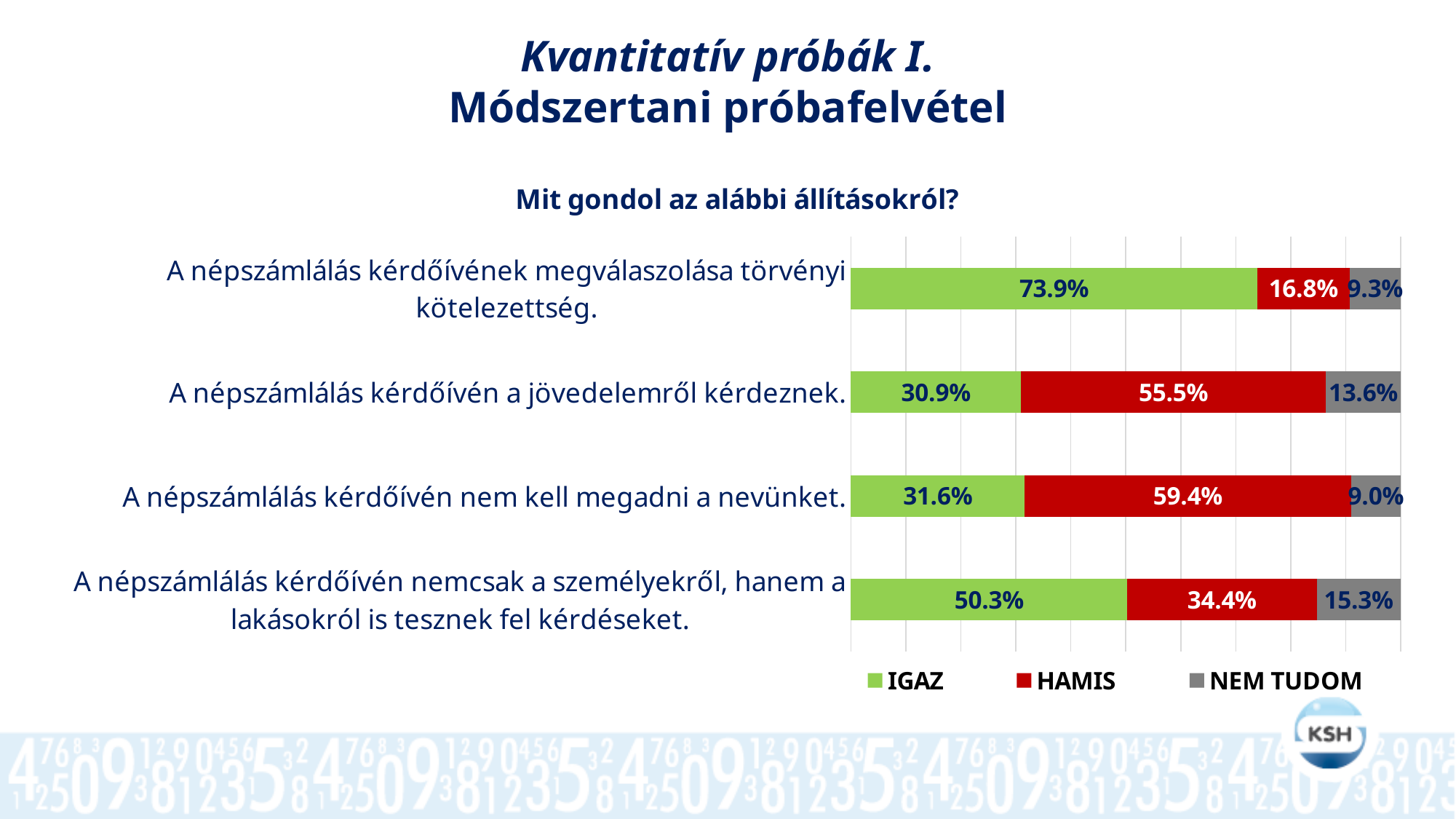
How many statements (categories) are shown in the chart? 4 How many series does the legend list? 3 What is the total of the stacked bar for "A népszámlálás kérdőívén nem kell megadni a nevünket."? 100.0% What is the IGAZ value for the statement "A népszámlálás kérdőívének megválaszolása törvényi kötelezettség."? 73.9% Which statement has the highest NEM TUDOM value? A népszámlálás kérdőívén nemcsak a személyekről, hanem a lakásokról is tesznek fel kérdéseket. What is the difference in percentage points between the HAMIS value for "A népszámlálás kérdőívén nem kell megadni a nevünket." and the HAMIS value for "A népszámlálás kérdőívén nemcsak a személyekről, hanem a lakásokról is tesznek fel kérdéseket."? 25.0 percentage points Which statement has the lowest HAMIS value? A népszámlálás kérdőívének megválaszolása törvényi kötelezettség. Which statement has the highest IGAZ value? A népszámlálás kérdőívének megválaszolása törvényi kötelezettség. Which is larger: the IGAZ value for "A népszámlálás kérdőívén a jövedelemről kérdeznek." or the IGAZ value for "A népszámlálás kérdőívén nem kell megadni a nevünket."? A népszámlálás kérdőívén nem kell megadni a nevünket. (31.6%) What is the HAMIS value for the statement "A népszámlálás kérdőívén a jövedelemről kérdeznek."? 55.5% What kind of chart is shown on the slide? Stacked horizontal bar chart What is the NEM TUDOM value for the statement "A népszámlálás kérdőívén nemcsak a személyekről, hanem a lakásokról is tesznek fel kérdéseket."? 15.3%